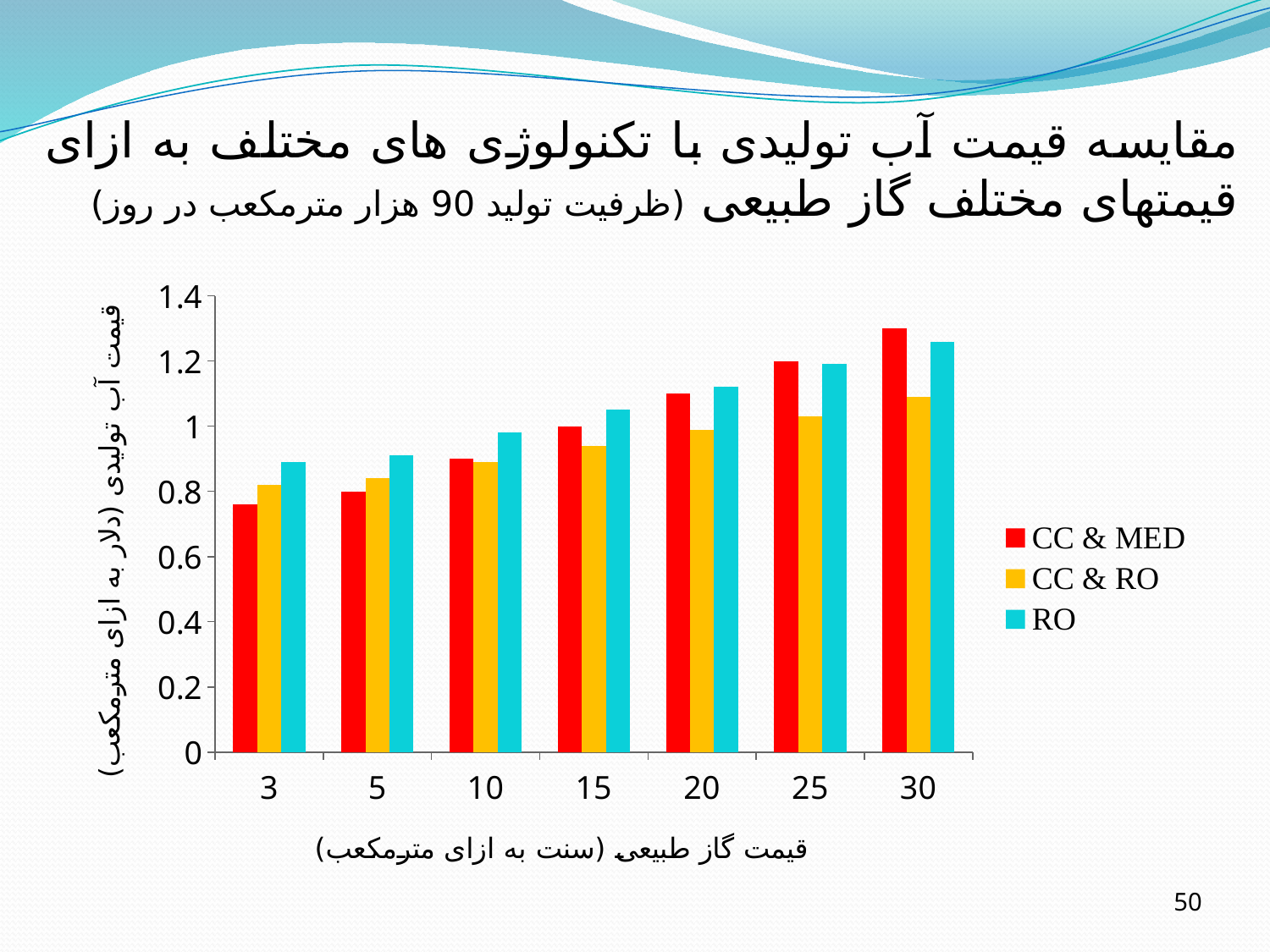
Which series has the lowest value at a gas price of 30? CC & RO At a gas price of 3, which is larger: RO or CC & MED? RO What kind of chart is shown on the slide? bar chart How many natural gas price categories are shown on the x axis? 7 How many series does the legend list? 3 Is the value for CC & RO at a gas price of 30 greater or less than 1.2? less At a gas price of 30, which is larger: CC & MED or CC & RO? CC & MED Is the value for RO at a gas price of 20 greater or less than 1? greater At which gas price is the CC & MED value highest? 30 Do the CC & MED values rise or fall as the gas price increases along the x axis? rise Is the value for CC & MED at a gas price of 30 greater or less than 1.2? greater